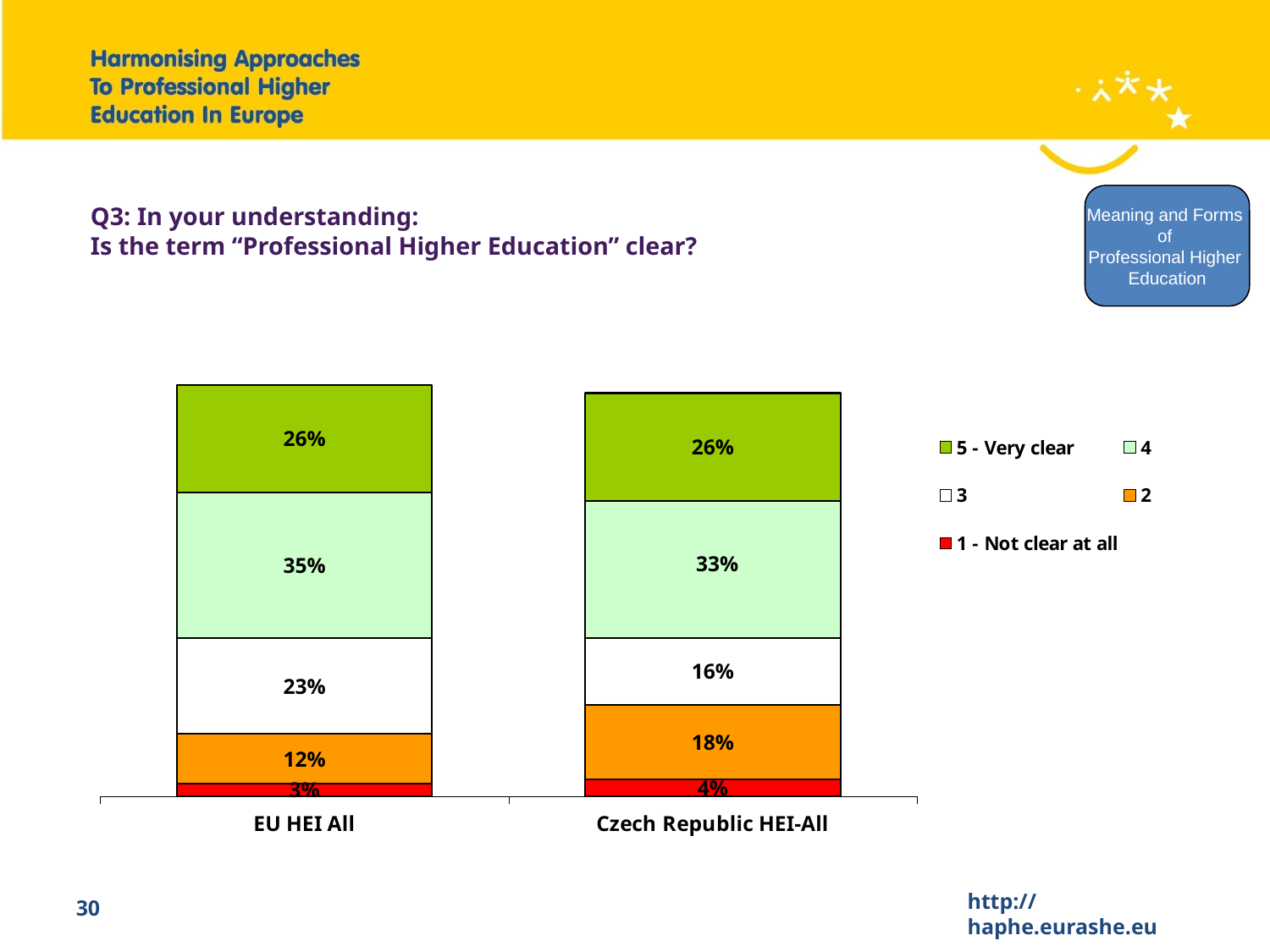
What is the value for '5 - Very clear' in the Czech Republic HEI-All bar? 26% How much larger is the '3' share for EU HEI All than for Czech Republic HEI-All? 7 percentage points Which rating has the smallest share in the Czech Republic HEI-All bar? 1 - Not clear at all How much larger is the '2' share for Czech Republic HEI-All than for EU HEI All? 6 percentage points How many series does the legend list? 5 What is the value for '1 - Not clear at all' in the Czech Republic HEI-All bar? 4% Which group has the larger share of '4' ratings, EU HEI All or Czech Republic HEI-All? EU HEI All Which rating has the largest share in the EU HEI All bar? 4 What percentage of Czech Republic HEI-All respondents rated the term as 3? 16% What kind of chart is shown on the slide? Stacked bar chart What is the value for the '2' segment in the EU HEI All bar? 12% What percentage of EU HEI All respondents rated the term as 4? 35%